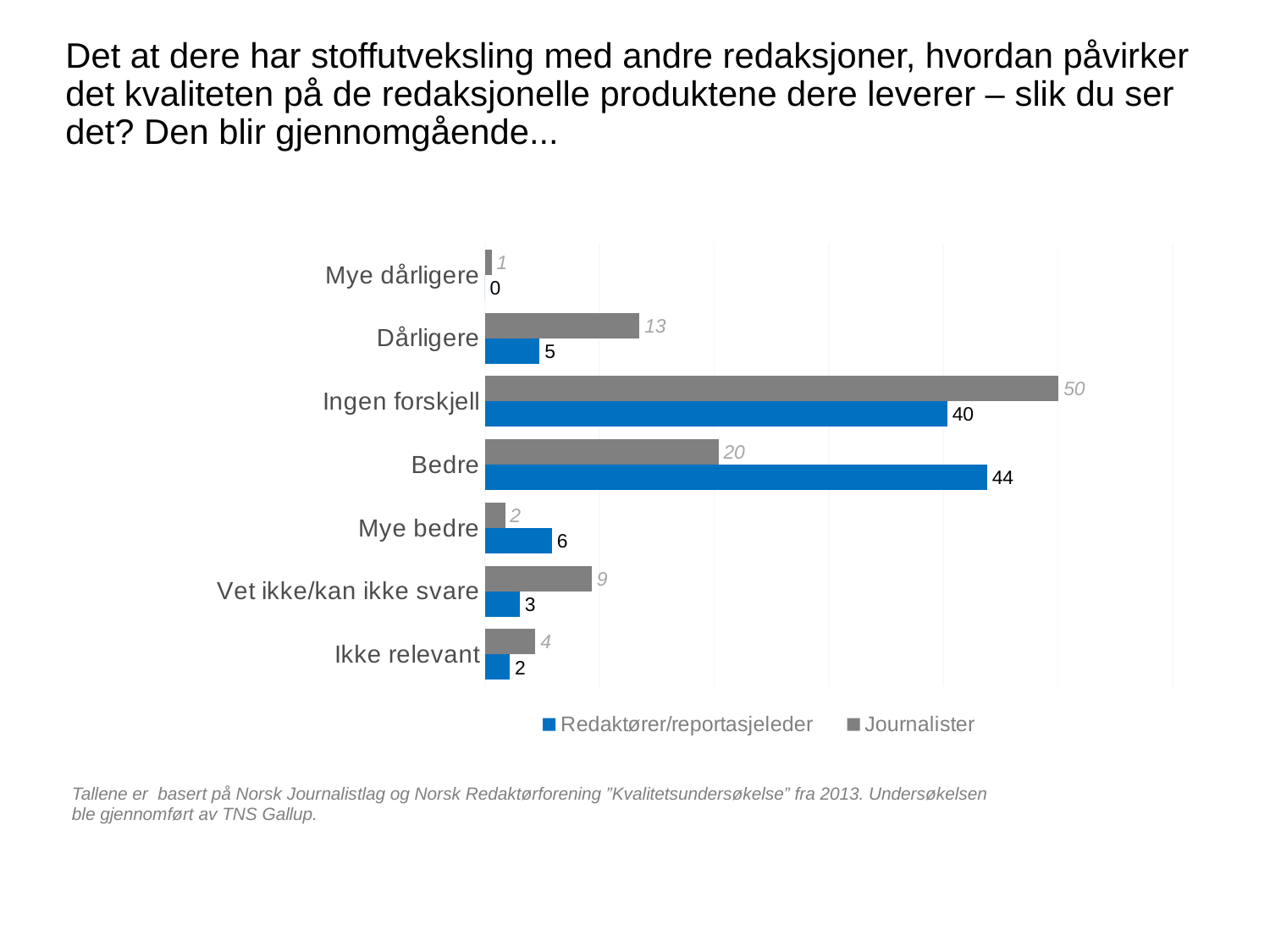
How many series does the legend list? 2 What is the difference between the Journalister and Redaktører/reportasjeleder values in the Bedre category? 24 What is the value for Journalister in the Vet ikke/kan ikke svare category? 9 Which category has the lowest value for Journalister? Mye dårligere What kind of chart is shown on the slide? Bar chart Which category has the highest value for Journalister? Ingen forskjell In the Dårligere category, which series has the larger value, Redaktører/reportasjeleder or Journalister? Journalister What is the value for Journalister in the Ingen forskjell category? 50 Which category has the highest value for Redaktører/reportasjeleder? Bedre How many categories are shown on the chart? 7 What is the value for Redaktører/reportasjeleder in the Bedre category? 44 What is the value for Redaktører/reportasjeleder in the Mye dårligere category? 0